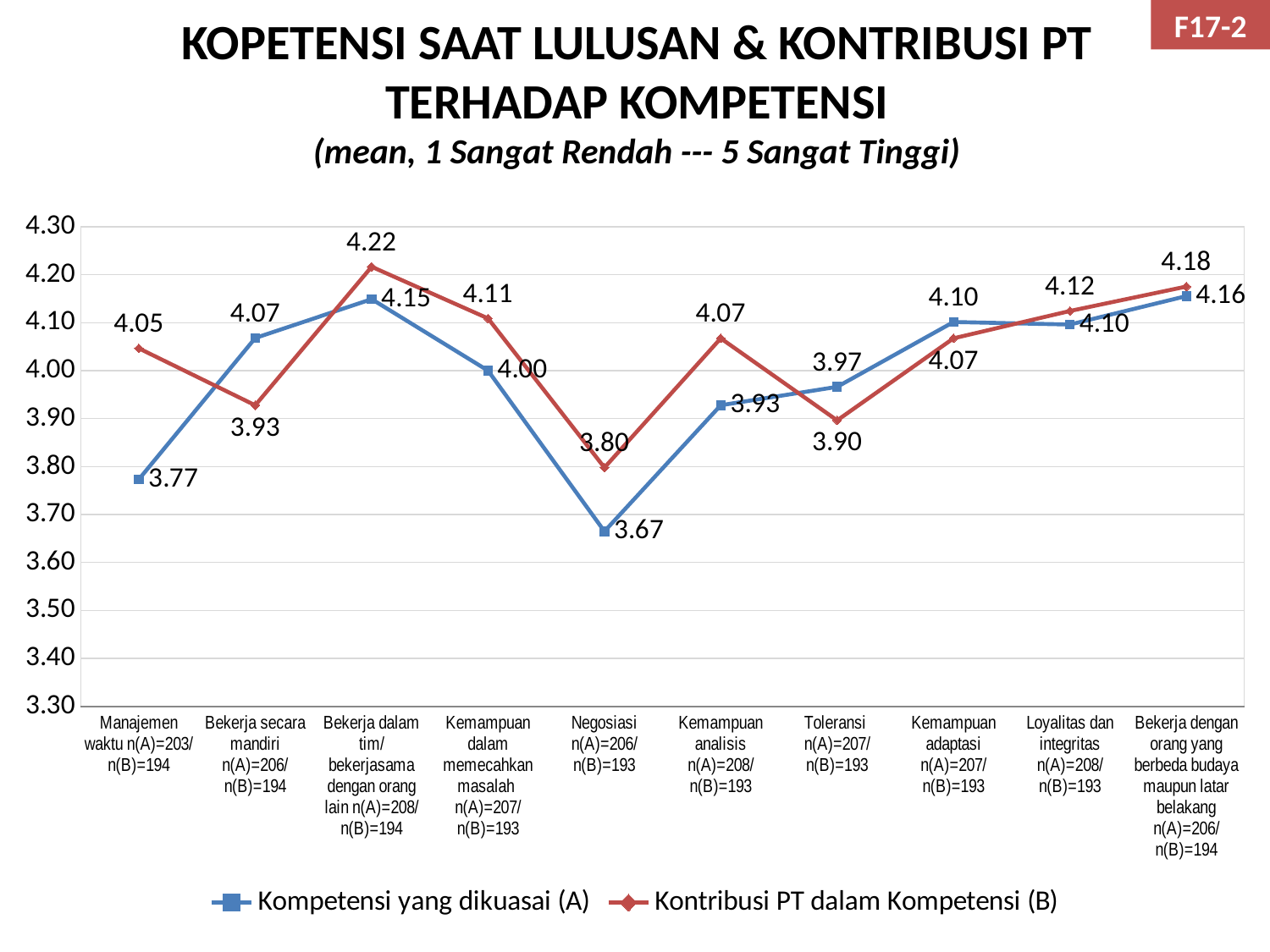
What is the difference between Kontribusi PT dalam Kompetensi (B) and Kompetensi yang dikuasai (A) for Manajemen waktu? 0.28 What is the value of Kontribusi PT dalam Kompetensi (B) for Manajemen waktu? 4.05 What kind of chart is shown on the slide? Line chart How many series does the legend list? 2 What is the value of Kompetensi yang dikuasai (A) for Negosiasi? 3.67 Which category has the lowest value for Kompetensi yang dikuasai (A)? Negosiasi What is the value of Kontribusi PT dalam Kompetensi (B) for Bekerja dalam tim/bekerjasama dengan orang lain? 4.22 Which category has the highest value for Kontribusi PT dalam Kompetensi (B)? Bekerja dalam tim/bekerjasama dengan orang lain How many categories are shown on the x axis of the chart? 10 Which category has the lowest value for Kontribusi PT dalam Kompetensi (B)? Negosiasi For Toleransi, which series has the larger value: Kompetensi yang dikuasai (A) or Kontribusi PT dalam Kompetensi (B)? Kompetensi yang dikuasai (A) For Kemampuan analisis, which series has the larger value: Kompetensi yang dikuasai (A) or Kontribusi PT dalam Kompetensi (B)? Kontribusi PT dalam Kompetensi (B)